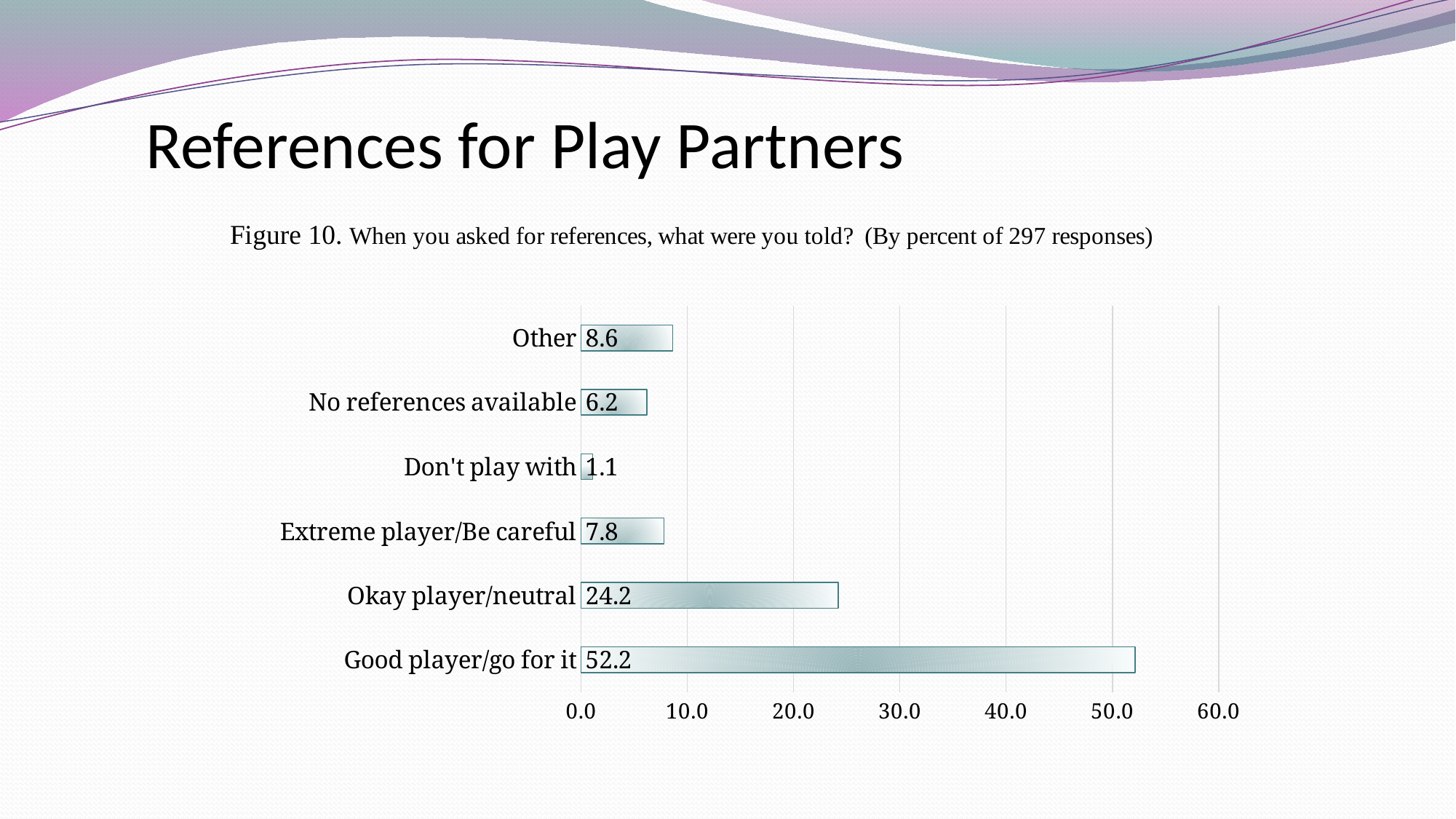
What is the value for "No references available"? 6.2 How many categories are shown in the chart? 6 According to the figure caption, how many responses is the chart based on? 297 Is the value for "Good player/go for it" greater or less than 50.0? greater What is the value for "Okay player/neutral"? 24.2 What is the value for "Extreme player/Be careful"? 7.8 Which category has the lowest value? Don't play with Which category has the highest value? Good player/go for it Which is larger, the value for "Other" or the value for "Extreme player/Be careful"? Other What kind of chart is shown on the slide? bar chart What is the value for "Good player/go for it"? 52.2 What is the difference between the values for "Good player/go for it" and "Okay player/neutral"? 28.0